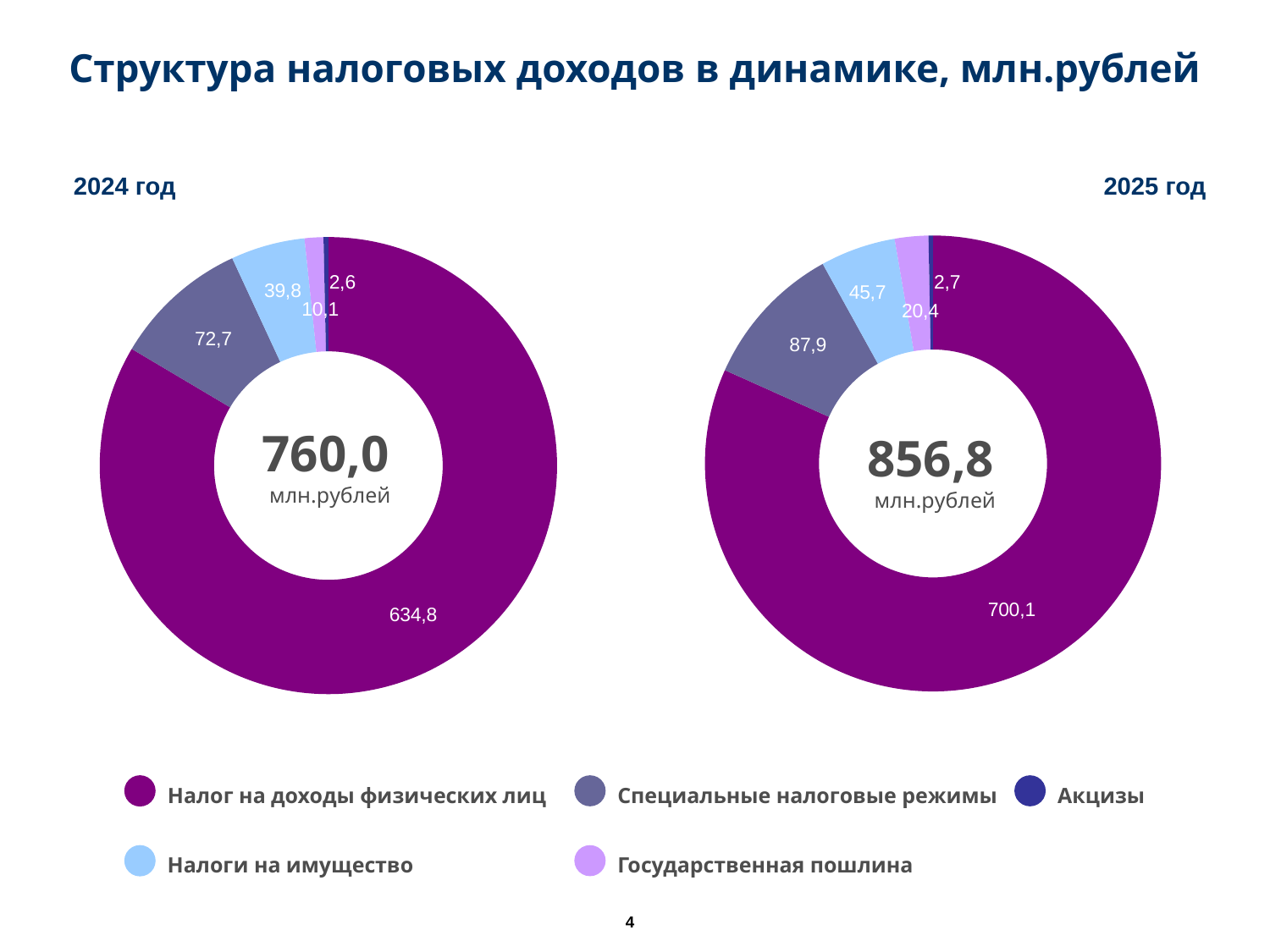
How many categories does each donut chart show? 5 What total is shown in the centre of the 2025 chart? 856,8 млн.рублей Which legend entry is shown in dark blue? Акцизы In the 2024 chart, which is larger: Специальные налоговые режимы or Налоги на имущество? Специальные налоговые режимы In the 2024 chart, what is the value for Налог на доходы физических лиц? 634,8 In the 2025 chart, which category has the smallest slice? Акцизы In the 2025 chart, what is the value for Специальные налоговые режимы? 87,9 What is the difference between the value for Налог на доходы физических лиц in the 2025 chart and in the 2024 chart? 65,3 In the 2025 chart, what is the value for Налоги на имущество? 45,7 What type of chart is used on this slide? Donut (pie) chart In the 2024 chart, what is the value for Государственная пошлина? 10,1 In the 2024 chart, which category has the largest slice? Налог на доходы физических лиц